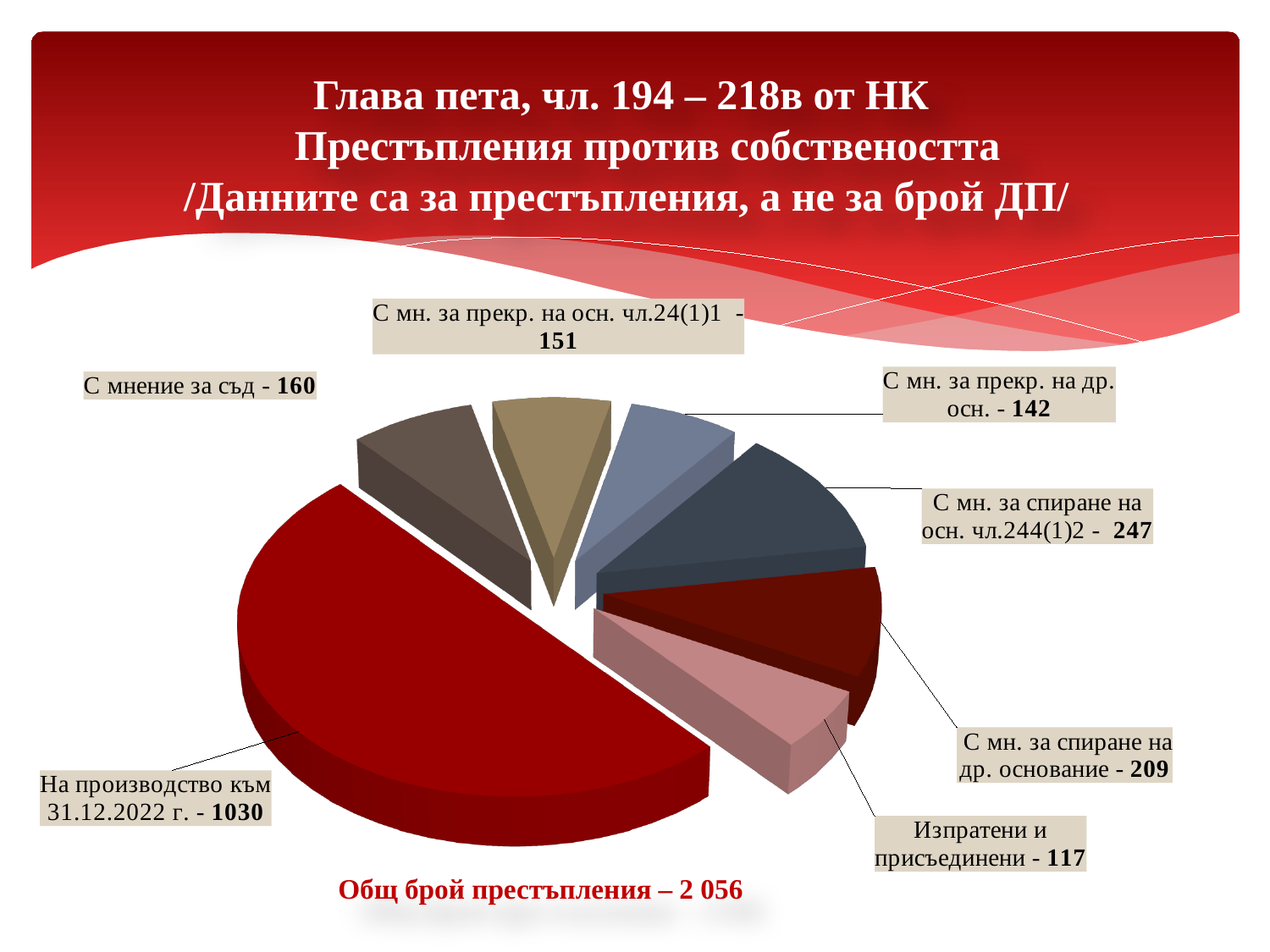
What is the value for "На производство към 31.12.2022 г."? 1030 What total number of crimes is stated below the chart? 2 056 Which category has the smallest slice of the pie? Изпратени и присъединени What is the difference between "С мнение за съд" and "С мн. за прекр. на осн. чл.24(1)1"? 9 Which category has the largest slice of the pie? На производство към 31.12.2022 г. Which is larger: "С мн. за прекр. на осн. чл.24(1)1" or "С мн. за прекр. на др. осн."? С мн. за прекр. на осн. чл.24(1)1 What is the difference between "С мн. за спиране на осн. чл.244(1)2" and "С мн. за спиране на др. основание"? 38 What is the value for "С мнение за съд"? 160 What is the value for "Изпратени и присъединени"? 117 What is the value for "С мн. за спиране на осн. чл.244(1)2"? 247 How many slices does the pie chart have? 7 What type of chart is shown on the slide? Pie chart